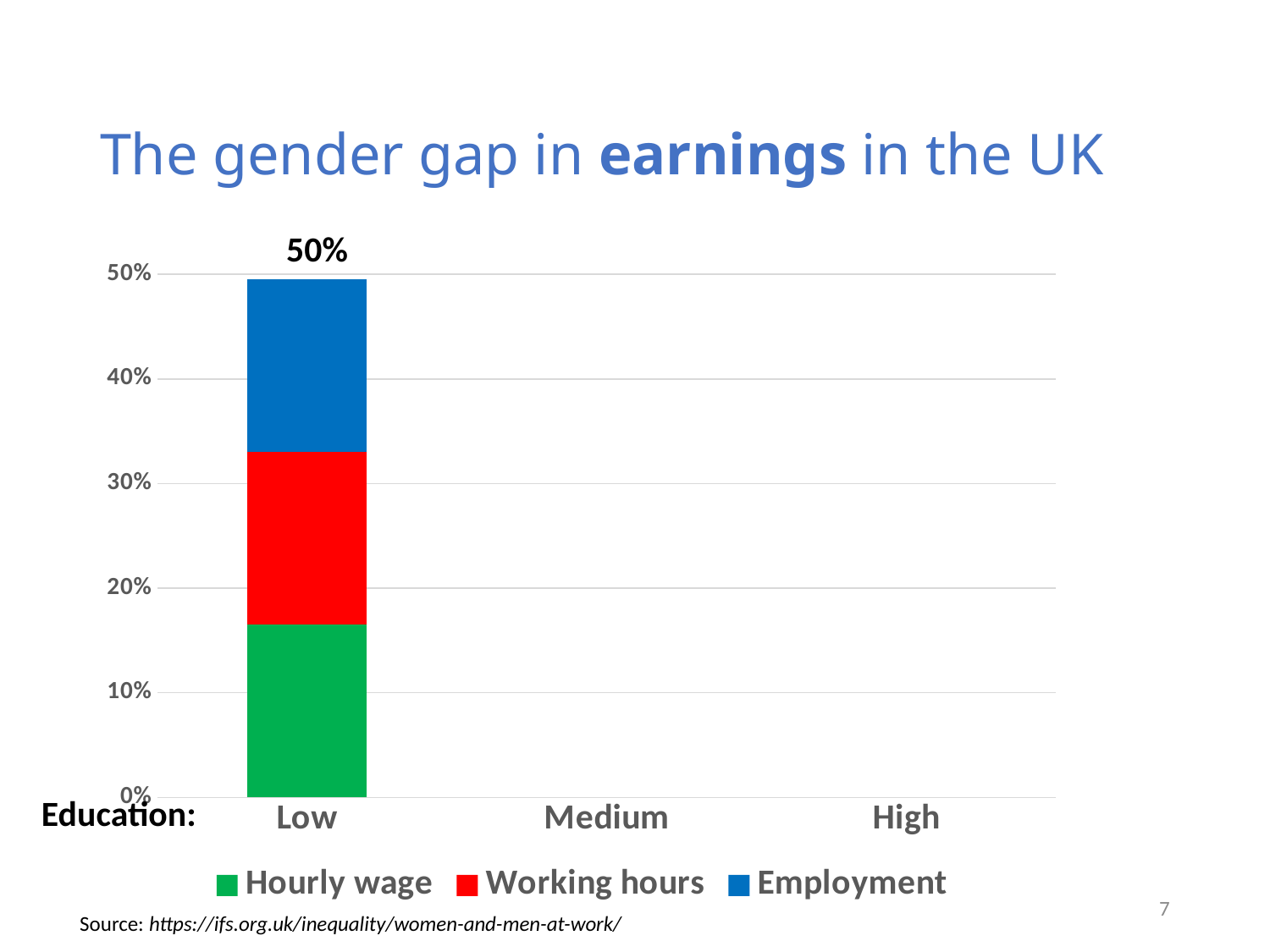
Which series is shown in green in the legend? Hourly wage How many series does the legend list? 3 Which education category has the highest total gender gap in earnings shown on the chart? Low What is the title of the slide containing the chart? The gender gap in earnings in the UK Is the top of the Working hours segment in the Low education bar above or below the 30% gridline? above What is the total value printed above the stacked bar for the Low education category? 50% Which colour represents the Employment series in the legend? blue Is the top of the Employment segment in the Low education bar above or below the 40% gridline? above How many education categories are shown on the x axis? 3 Is the Hourly wage segment for the Low education category greater or less than 20%? less What kind of chart is shown on the slide? bar chart